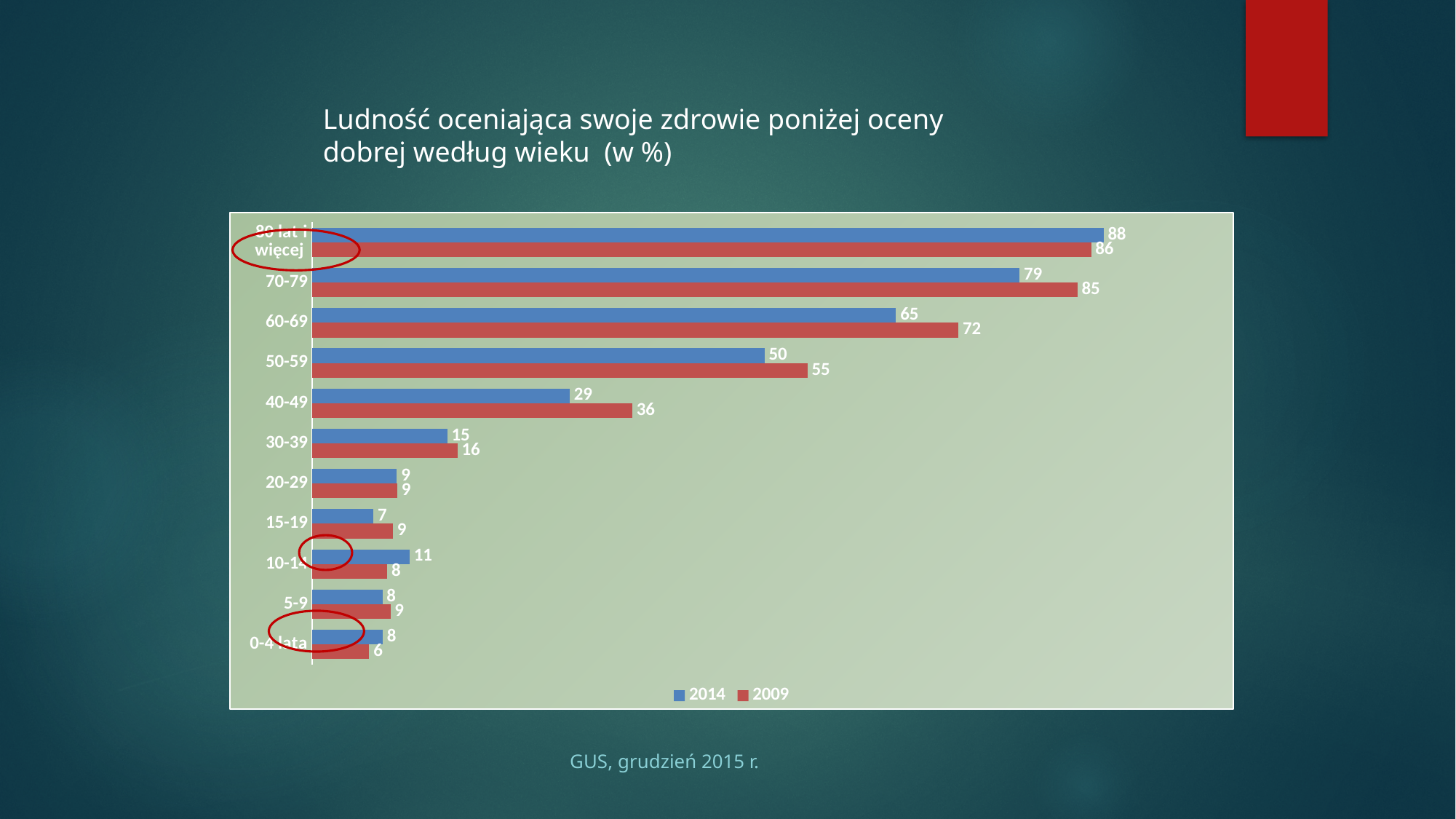
How many series does the legend list? 2 What is the 2009 value for the 40-49 age group? 36 Which age group has the lowest 2009 value? 0-4 lata What is the 2014 value for the 10-14 age group? 11 Which colour represents the 2009 series in the chart? Red For the 10-14 age group, which year has the larger value, 2014 or 2009? 2014 What is the highest value shown in the 2014 series? 88 How many age groups are shown on the chart? 11 What type of chart is shown on the slide? Bar chart What is the difference between the 2009 and 2014 values for the 70-79 age group? 6 What is the 2014 value for the 60-69 age group? 65 For the 50-59 age group, which year has the larger value, 2014 or 2009? 2009